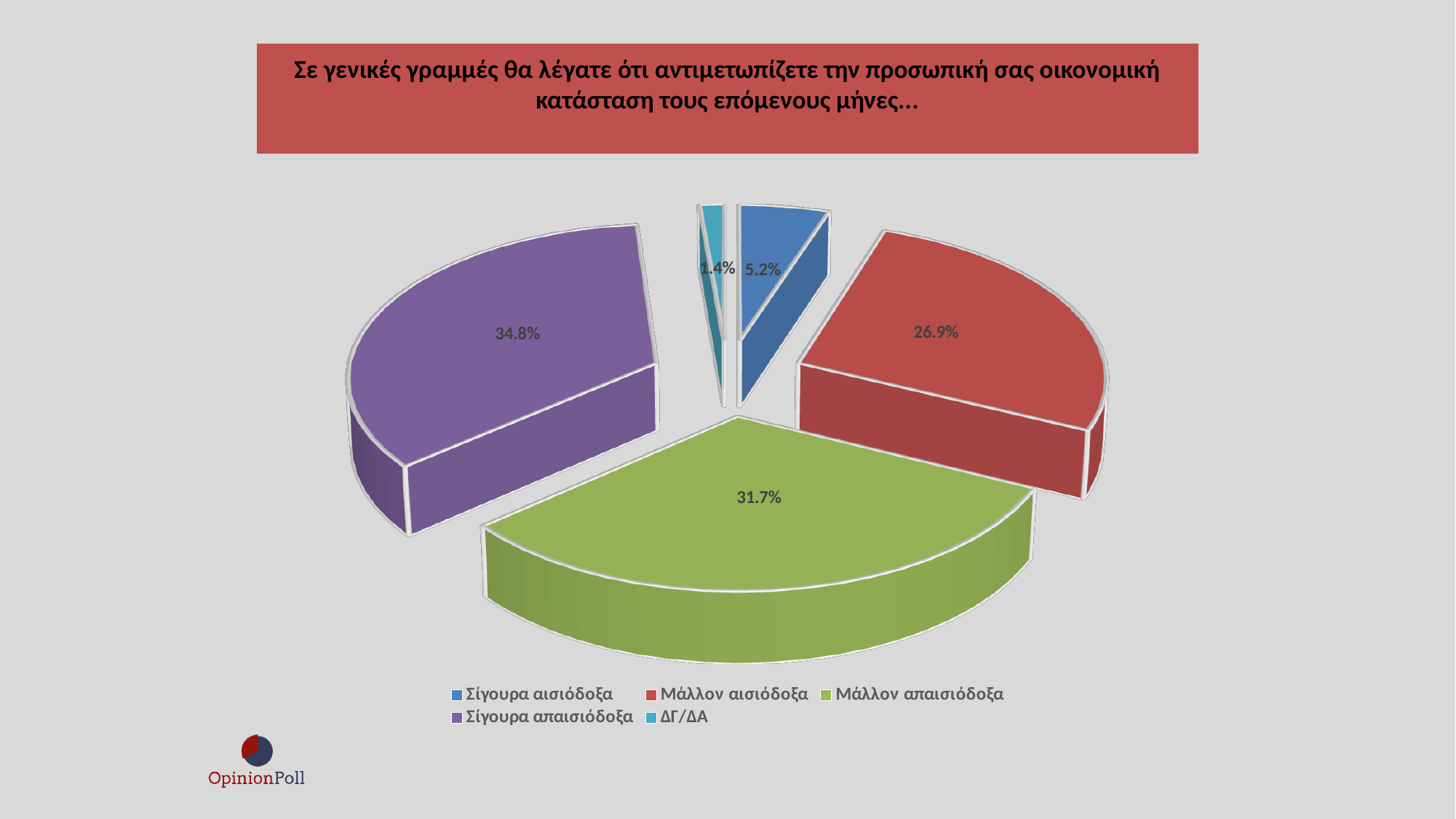
What percentage is shown for Μάλλον αισιόδοξα? 26.9% What is the difference in percentage points between Μάλλον απαισιόδοξα and Μάλλον αισιόδοξα? 4.8 Which is larger, the share for Σίγουρα αισιόδοξα or the share for ΔΓ/ΔΑ? Σίγουρα αισιόδοξα What percentage is shown for Σίγουρα αισιόδοξα? 5.2% What percentage is shown for Σίγουρα απαισιόδοξα? 34.8% Which category has the smallest share of the pie? ΔΓ/ΔΑ What kind of chart is shown on the slide? Pie chart Which colour represents Μάλλον απαισιόδοξα in the legend? Green Which category has the largest share of the pie? Σίγουρα απαισιόδοξα What percentage is shown for ΔΓ/ΔΑ? 1.4% How many slices does the pie chart have? 5 What is the combined percentage of Σίγουρα απαισιόδοξα and Μάλλον απαισιόδοξα? 66.5%